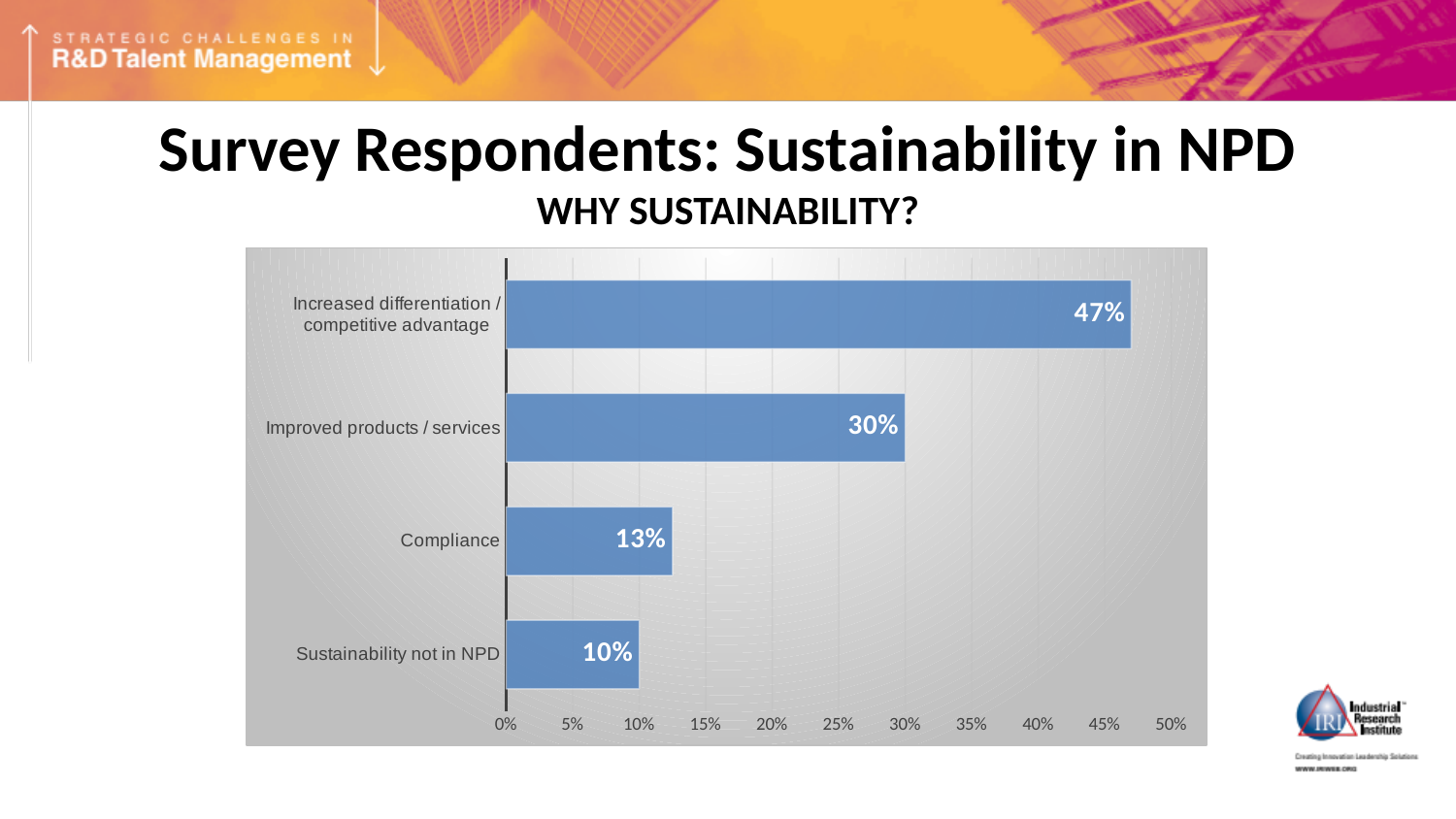
What is the difference between Compliance and Sustainability not in NPD? 3% What is the difference between Increased differentiation / competitive advantage and Improved products / services? 17% What kind of chart is shown on the slide? Bar chart What percentage of respondents cited Increased differentiation / competitive advantage? 47% What is the subtitle shown above the chart? WHY SUSTAINABILITY? How many categories are shown in the chart? 4 Which category has the lowest value? Sustainability not in NPD What is the value for Improved products / services? 30% Which is larger, Improved products / services or Compliance? Improved products / services What is the value for Sustainability not in NPD? 10% Which category has the highest value? Increased differentiation / competitive advantage What is the value for Compliance? 13%